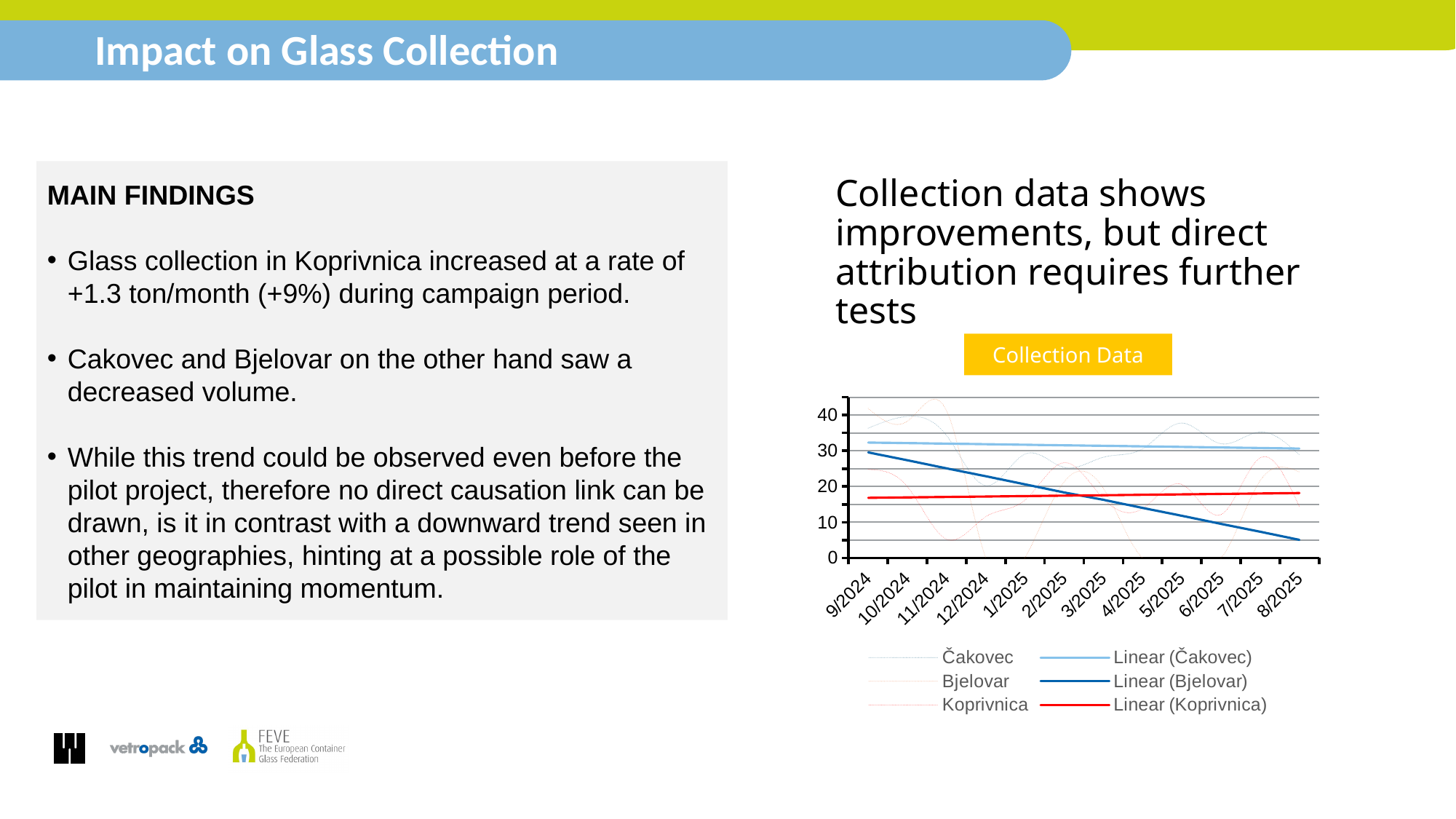
Does the Linear (Koprivnica) trendline rise or fall from 9/2024 to 8/2025? rise Is the value of the Linear (Čakovec) trendline at 9/2024 greater or less than 30? greater At 8/2025, which trendline is higher: Linear (Čakovec) or Linear (Bjelovar)? Linear (Čakovec) How many entries does the chart legend list? 6 Does the Linear (Bjelovar) trendline rise or fall from 9/2024 to 8/2025? fall What colour is the Linear (Koprivnica) trendline in the chart? red Is the value of the Linear (Koprivnica) trendline at 9/2024 greater or less than 20? less What is the title of the chart? Collection Data What kind of chart is shown on the slide? line chart At 9/2024, which trendline is higher: Linear (Bjelovar) or Linear (Koprivnica)? Linear (Bjelovar) Is the value of the Linear (Bjelovar) trendline at 8/2025 greater or less than 10? less How many months are shown along the x axis of the chart? 12